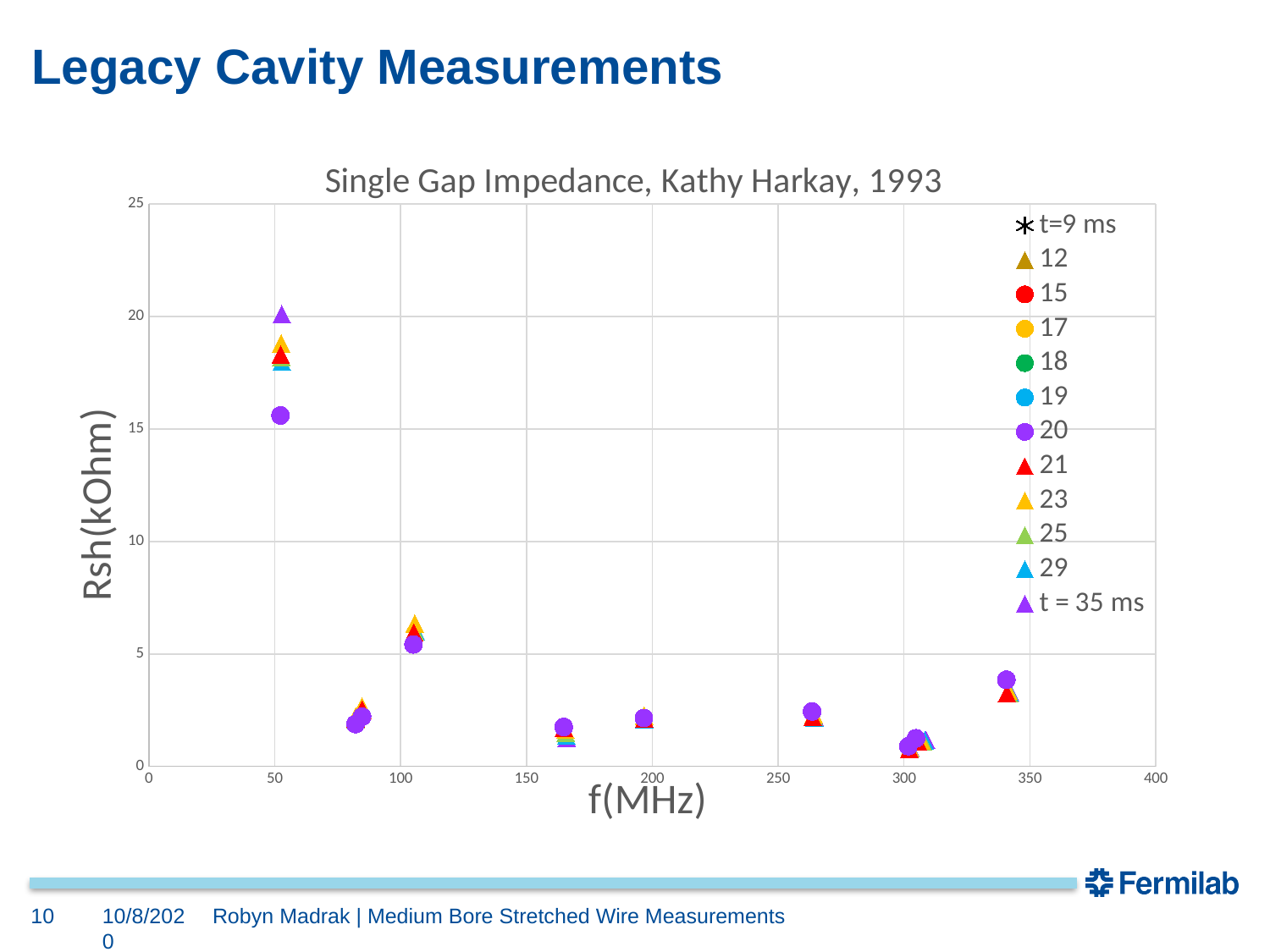
What kind of chart is shown on the slide? scatter chart How many series does the chart's legend list? 12 Are the values plotted near 200 MHz greater or less than 5 kOhm? less Do the Rsh values rise or fall as frequency increases from 50 MHz to 150 MHz? fall What is the label of the chart's y axis? Rsh(kOhm) Which is larger: the value for the series labelled 20 near 50 MHz or its value near 100 MHz? near 50 MHz Are the values plotted near 100 MHz greater or less than 10 kOhm? less Is the value for the series labelled 20 near 50 MHz greater or less than 10 kOhm? greater Which series has the highest plotted point on the chart? t = 35 ms What is the title of the chart? Single Gap Impedance, Kathy Harkay, 1993